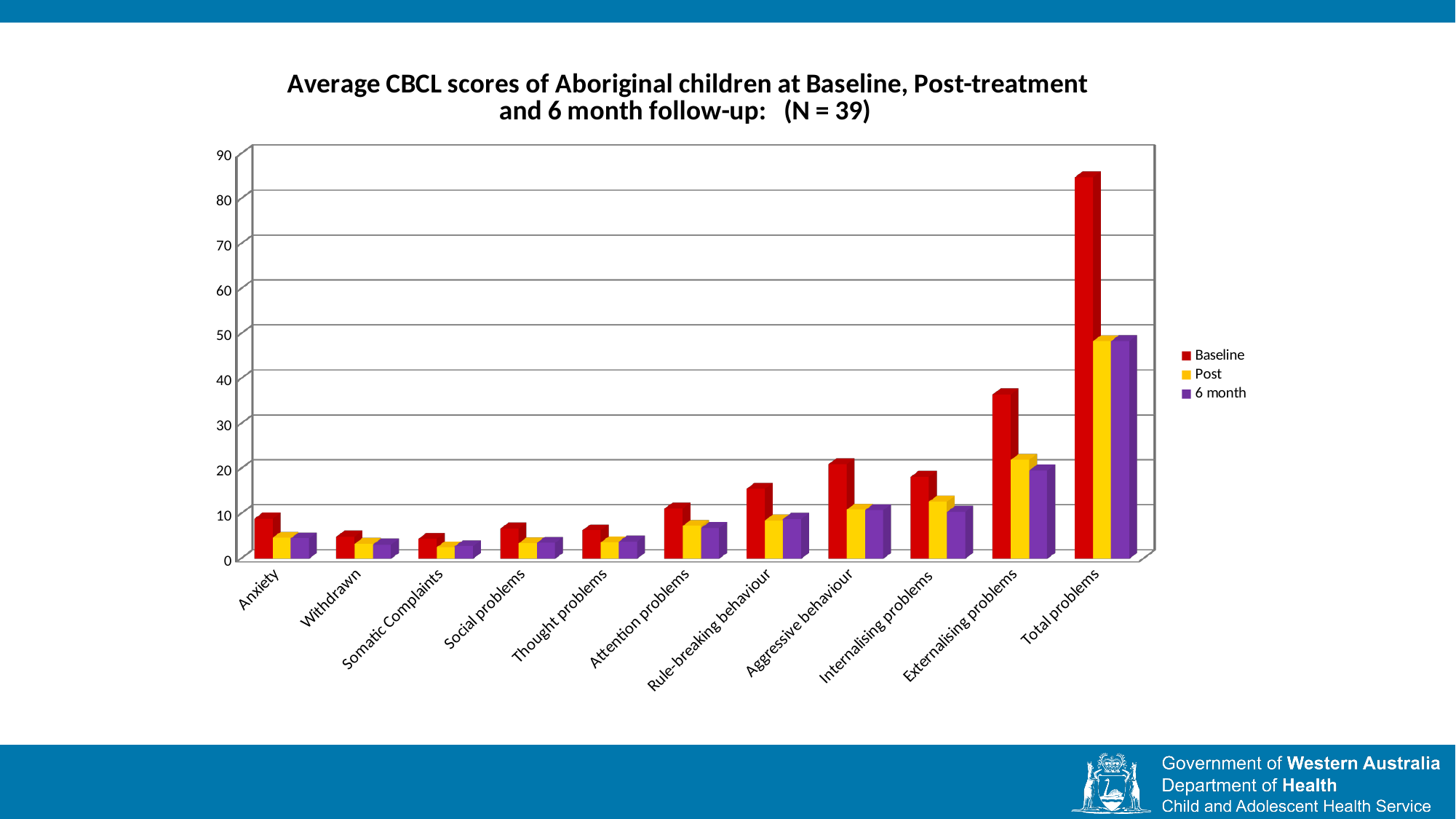
Which series is shown in red in the legend? Baseline Is the Baseline value for Externalising problems greater or less than 30? greater How many series does the legend list? 3 How many categories are shown along the x axis? 11 Is the 6 month value for Externalising problems greater or less than 30? less Which is larger, the Baseline value for Externalising problems or the Baseline value for Internalising problems? Externalising problems Which category has the highest Baseline value? Total problems Which is larger, the Baseline value for Anxiety or the Baseline value for Withdrawn? Anxiety What kind of chart is shown on the slide? bar chart Is the Baseline value for Total problems greater or less than 80? greater